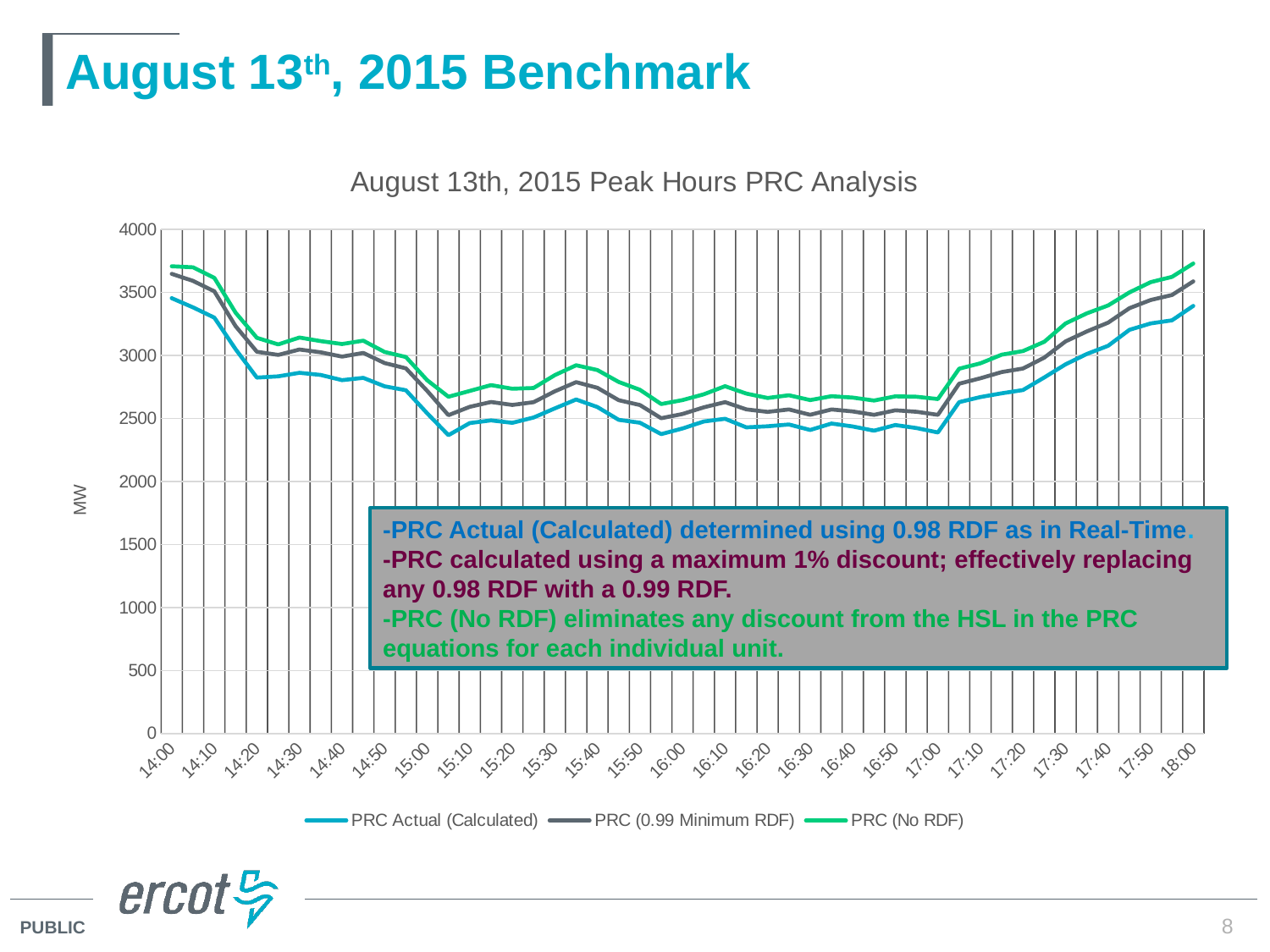
How many time labels are shown along the x axis? 25 At 14:00, which is larger: PRC (No RDF) or PRC Actual (Calculated)? PRC (No RDF) What kind of chart is shown on the slide? line chart Does the PRC Actual (Calculated) line rise or fall from 14:00 to 15:10? fall What is the label on the y axis of the chart? MW How many series does the legend list? 3 Is the value for PRC (No RDF) at 16:00 greater or less than 2500? greater Is the value for PRC (0.99 Minimum RDF) at 18:00 greater or less than 3000? greater What is the title of the chart? August 13th, 2015 Peak Hours PRC Analysis Is the value for PRC Actual (Calculated) at 14:00 greater or less than 3000? greater